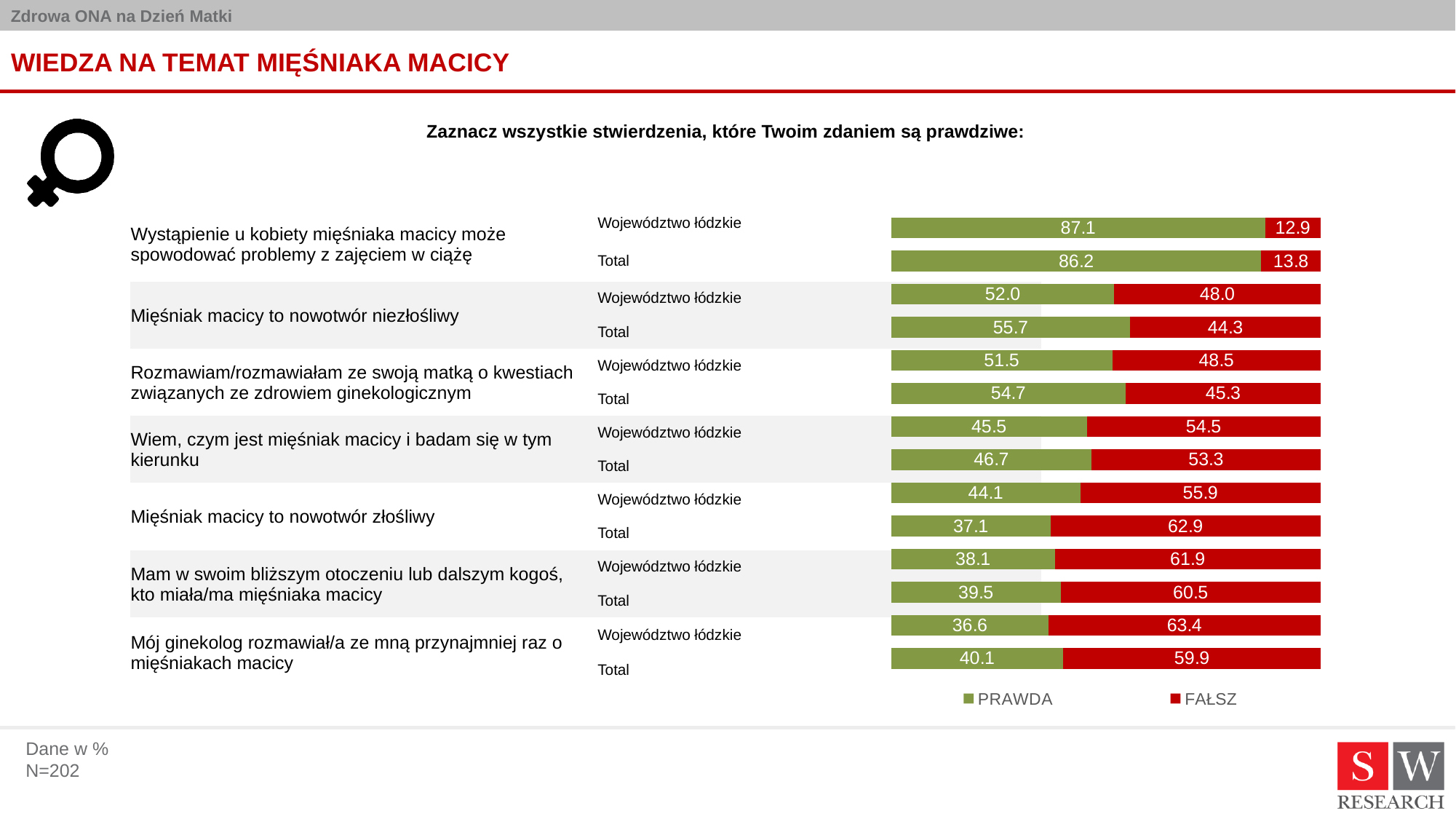
For the statement "Wiem, czym jest mięśniak macicy i badam się w tym kierunku", which is larger for Total: PRAWDA or FAŁSZ? FAŁSZ What is the difference between the Total PRAWDA value and the Województwo łódzkie PRAWDA value for the statement "Mięśniak macicy to nowotwór złośliwy"? 7.0 What is the total of the stacked bar for Total for the statement "Mam w swoim bliższym otoczeniu lub dalszym kogoś, kto miała/ma mięśniaka macicy"? 100.0 How many bars are plotted in the chart? 14 Which bar has the highest PRAWDA value? Województwo łódzkie, "Wystąpienie u kobiety mięśniaka macicy może spowodować problemy z zajęciem w ciążę" (87.1) What is the PRAWDA value for Total for the statement "Wystąpienie u kobiety mięśniaka macicy może spowodować problemy z zajęciem w ciążę"? 86.2 What is the PRAWDA value for Województwo łódzkie for the statement "Mój ginekolog rozmawiał/a ze mną przynajmniej raz o mięśniakach macicy"? 36.6 Which bar has the lowest PRAWDA value? Województwo łódzkie, "Mój ginekolog rozmawiał/a ze mną przynajmniej raz o mięśniakach macicy" (36.6) How many series does the legend list? 2 What kind of chart is shown on the slide? Stacked bar chart What is the FAŁSZ value for Województwo łódzkie for the statement "Mięśniak macicy to nowotwór niezłośliwy"? 48.0 Which colour represents the FAŁSZ series in the chart? Red